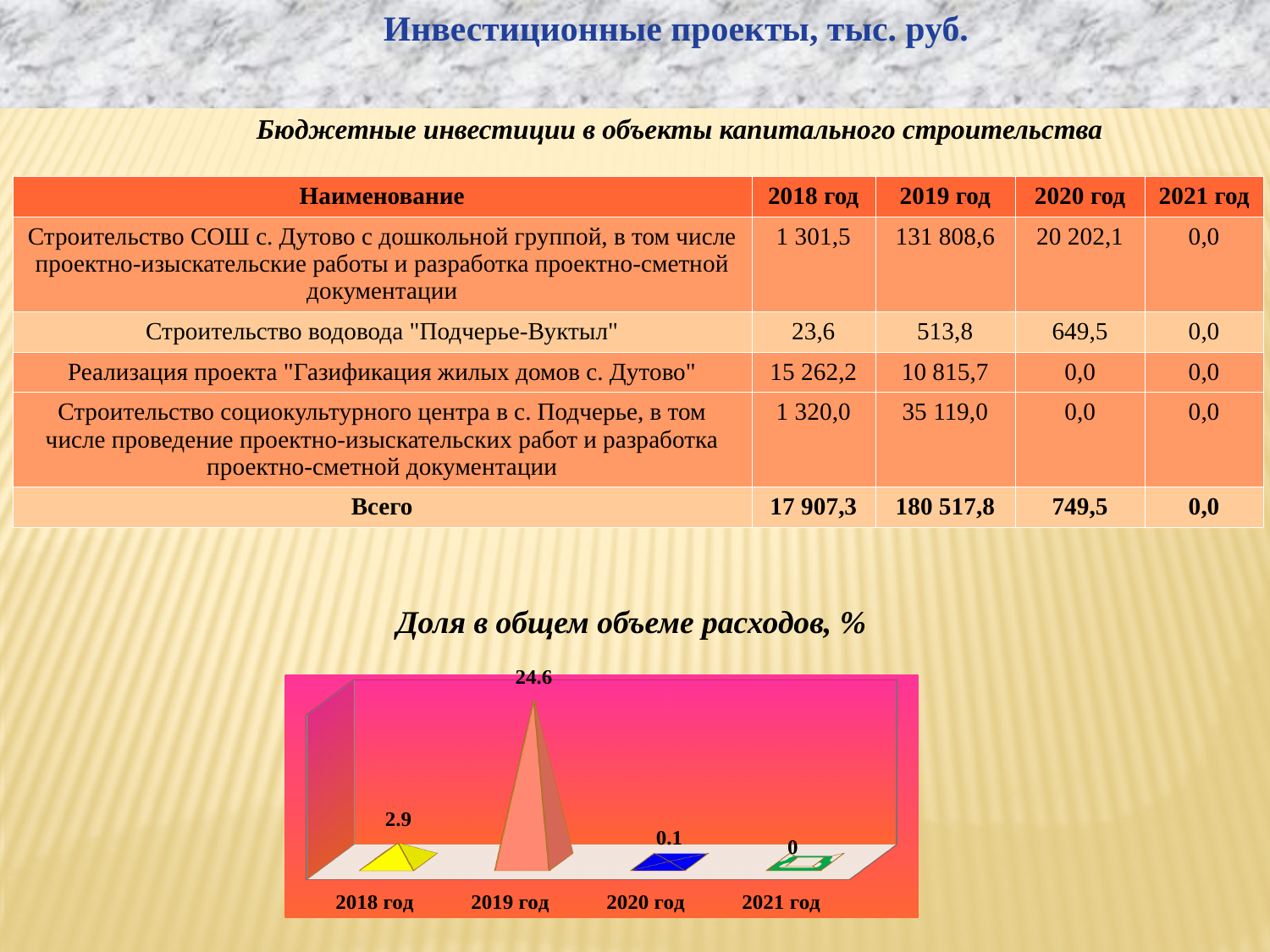
In the chart 'Доля в общем объеме расходов, %', do the values rise or fall from 2019 год to 2021 год? fall What is the value for 2021 год in the chart 'Доля в общем объеме расходов, %'? 0 How many years are shown on the x axis of the chart 'Доля в общем объеме расходов, %'? 4 What is the value for 2018 год in the chart 'Доля в общем объеме расходов, %'? 2.9 Which year has the lowest value in the chart 'Доля в общем объеме расходов, %'? 2021 год In the chart 'Доля в общем объеме расходов, %', what is the difference between the values for 2019 год and 2018 год? 21.7 Which year has the highest value in the chart 'Доля в общем объеме расходов, %'? 2019 год What kind of chart is 'Доля в общем объеме расходов, %'? bar chart What is the value for 2019 год in the chart 'Доля в общем объеме расходов, %'? 24.6 In the chart 'Доля в общем объеме расходов, %', which is larger: the value for 2018 год or the value for 2020 год? 2018 год What is the title of the chart at the bottom of the slide? Доля в общем объеме расходов, % What is the value for 2020 год in the chart 'Доля в общем объеме расходов, %'? 0.1